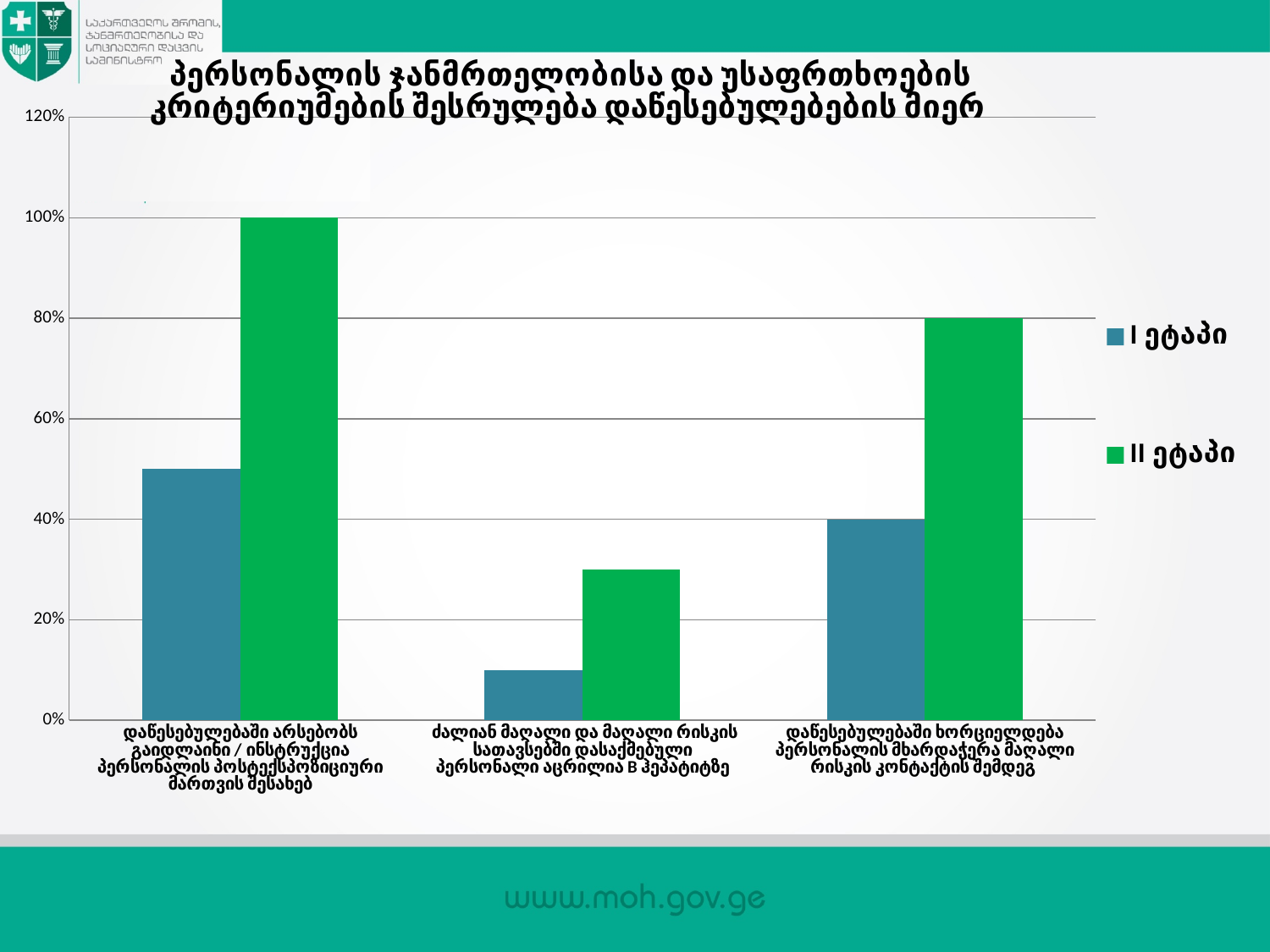
What is the value of I ეტაპი for the category 'დაწესებულებაში ხორციელდება პერსონალის მხარდაჭერა მაღალი რისკის კონტაქტის შემდეგ'? 40% Which category has the lowest I ეტაპი value? ძალიან მაღალი და მაღალი რისკის სათავსებში დასაქმებული პერსონალი აცრილია B ჰეპატიტზე Is the value of I ეტაპი for the category 'დაწესებულებაში არსებობს გაიდლაინი / ინსტრუქცია პერსონალის პოსტექსპოზიციური მართვის შესახებ' greater or less than 60%? less Is the value of II ეტაპი for the category 'ძალიან მაღალი და მაღალი რისკის სათავსებში დასაქმებული პერსონალი აცრილია B ჰეპატიტზე' greater or less than 20%? greater For the category 'დაწესებულებაში ხორციელდება პერსონალის მხარდაჭერა მაღალი რისკის კონტაქტის შემდეგ', which series has the larger value, I ეტაპი or II ეტაპი? II ეტაპი How many categories are shown on the x axis? 3 Which category has the highest II ეტაპი value? დაწესებულებაში არსებობს გაიდლაინი / ინსტრუქცია პერსონალის პოსტექსპოზიციური მართვის შესახებ How many series does the legend list? 2 What type of chart is shown on the slide? bar chart What is the value of II ეტაპი for the category 'დაწესებულებაში ხორციელდება პერსონალის მხარდაჭერა მაღალი რისკის კონტაქტის შემდეგ'? 80% What is the value of II ეტაპი for the category 'დაწესებულებაში არსებობს გაიდლაინი / ინსტრუქცია პერსონალის პოსტექსპოზიციური მართვის შესახებ'? 100% Is the value of I ეტაპი for the category 'ძალიან მაღალი და მაღალი რისკის სათავსებში დასაქმებული პერსონალი აცრილია B ჰეპატიტზე' greater or less than 20%? less